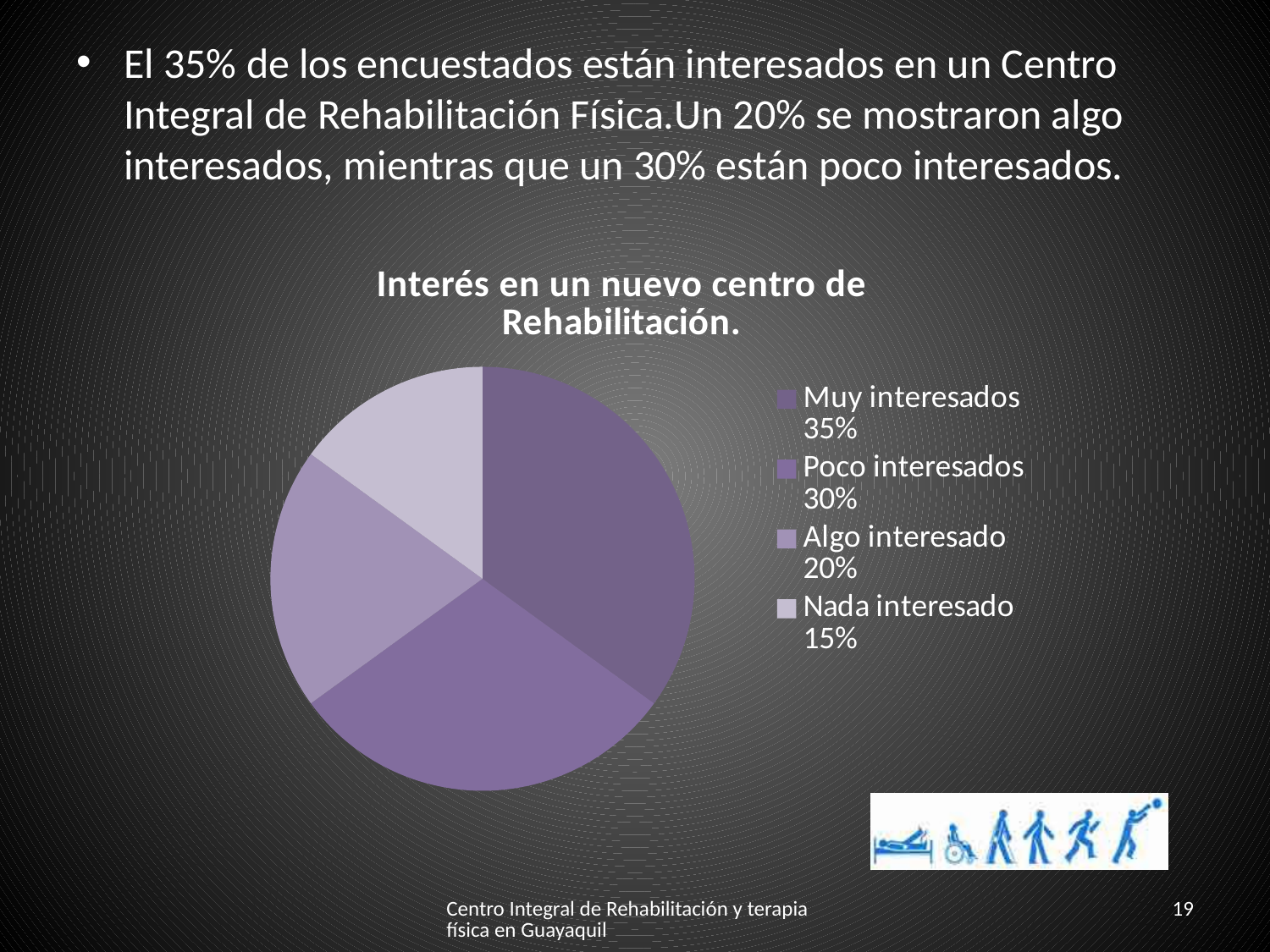
What share of the pie is 'Poco interesados'? 30% Which category has the largest slice of the pie? Muy interesados What share of the pie is 'Muy interesados'? 35% How many entries does the legend list? 4 What is the title of the chart? Interés en un nuevo centro de Rehabilitación. What share of the pie is 'Algo interesado'? 20% How many slices does the pie chart have? 4 What is the difference between the shares of 'Muy interesados' and 'Nada interesado'? 20% Which category has the smallest slice of the pie? Nada interesado Which is larger, the share for 'Poco interesados' or the share for 'Algo interesado'? Poco interesados What kind of chart is shown on the slide? pie chart